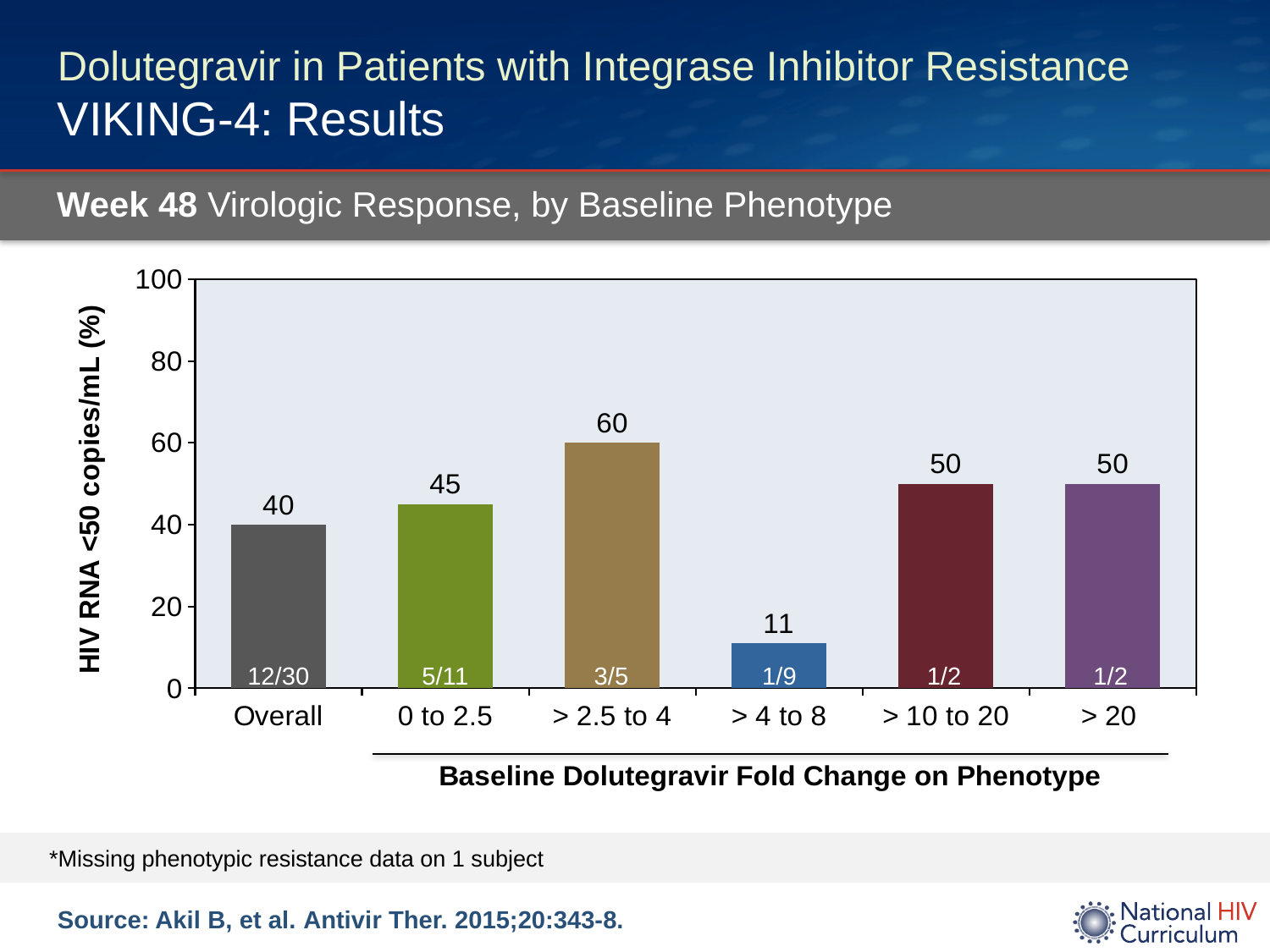
What kind of chart is shown on the slide? bar chart Which is larger, the value for 0 to 2.5 or the value for > 10 to 20? > 10 to 20 Which category has the lowest value? > 4 to 8 How many categories are shown on the x axis? 6 Which category has the highest value? > 2.5 to 4 What is the value for the Overall category? 40 What is the label of the y axis? HIV RNA <50 copies/mL (%) Is the value for Overall greater or less than 60? less What is the value for the > 2.5 to 4 category? 60 What is the value for the > 4 to 8 category? 11 What fraction is printed inside the bar for the > 4 to 8 category? 1/9 What is the difference between the values for > 2.5 to 4 and 0 to 2.5? 15